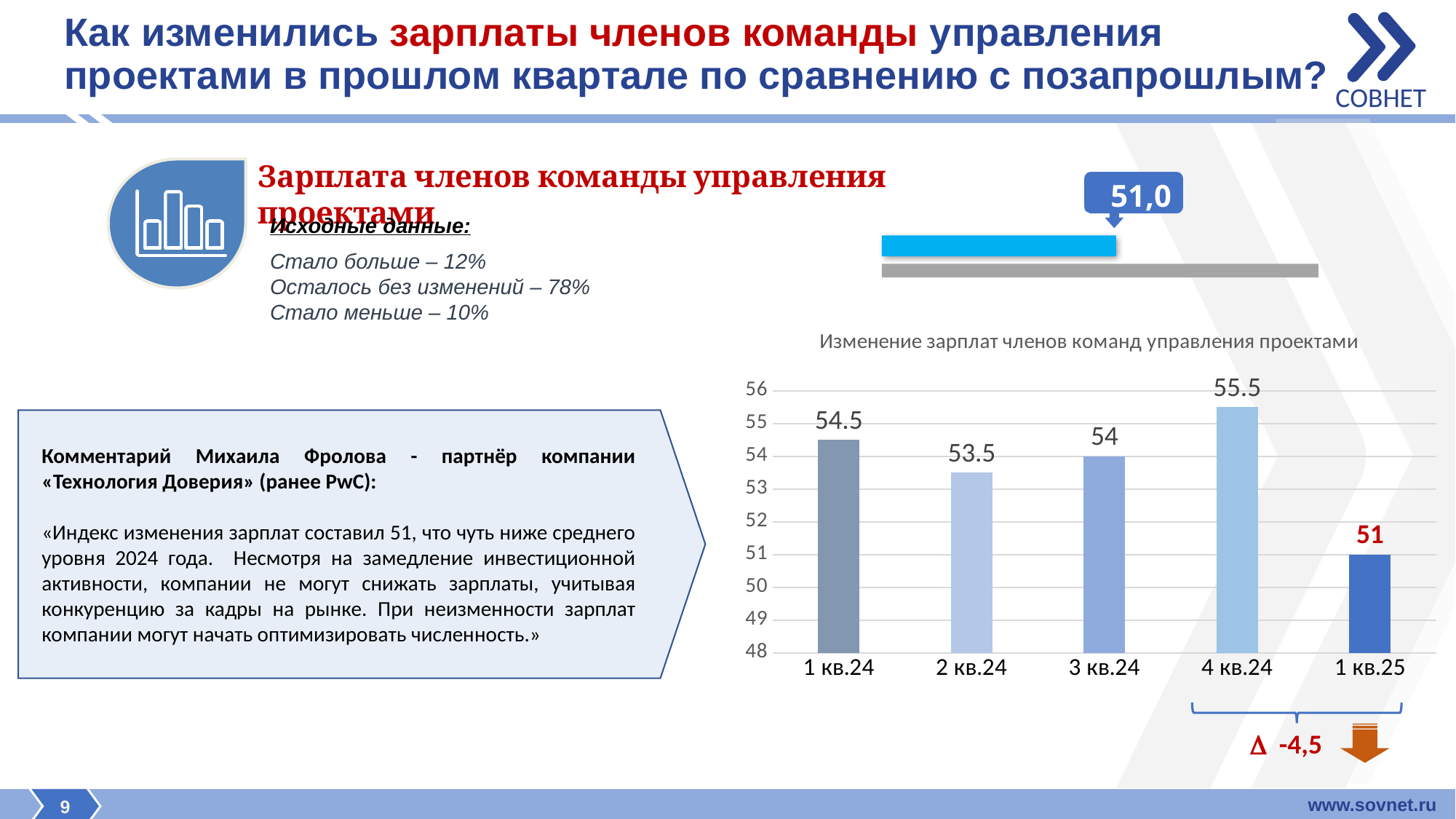
What is the value for 1 кв.25 in the chart? 51 How many quarters are shown on the x axis of the chart? 5 Does the value rise or fall from 4 кв.24 to 1 кв.25? Fall Which quarter has the highest value in the chart? 4 кв.24 What is the value for 3 кв.24 in the chart? 54 What is the value for 1 кв.24 in the chart "Изменение зарплат членов команд управления проектами"? 54.5 Which is larger, the value for 1 кв.24 or the value for 2 кв.24? 1 кв.24 What is the difference between the values for 4 кв.24 and 1 кв.25? 4.5 What is the value for 2 кв.24 in the chart? 53.5 What kind of chart is shown on the slide? Bar chart Which quarter has the lowest value in the chart? 1 кв.25 What is the title of the chart on the slide? Изменение зарплат членов команд управления проектами